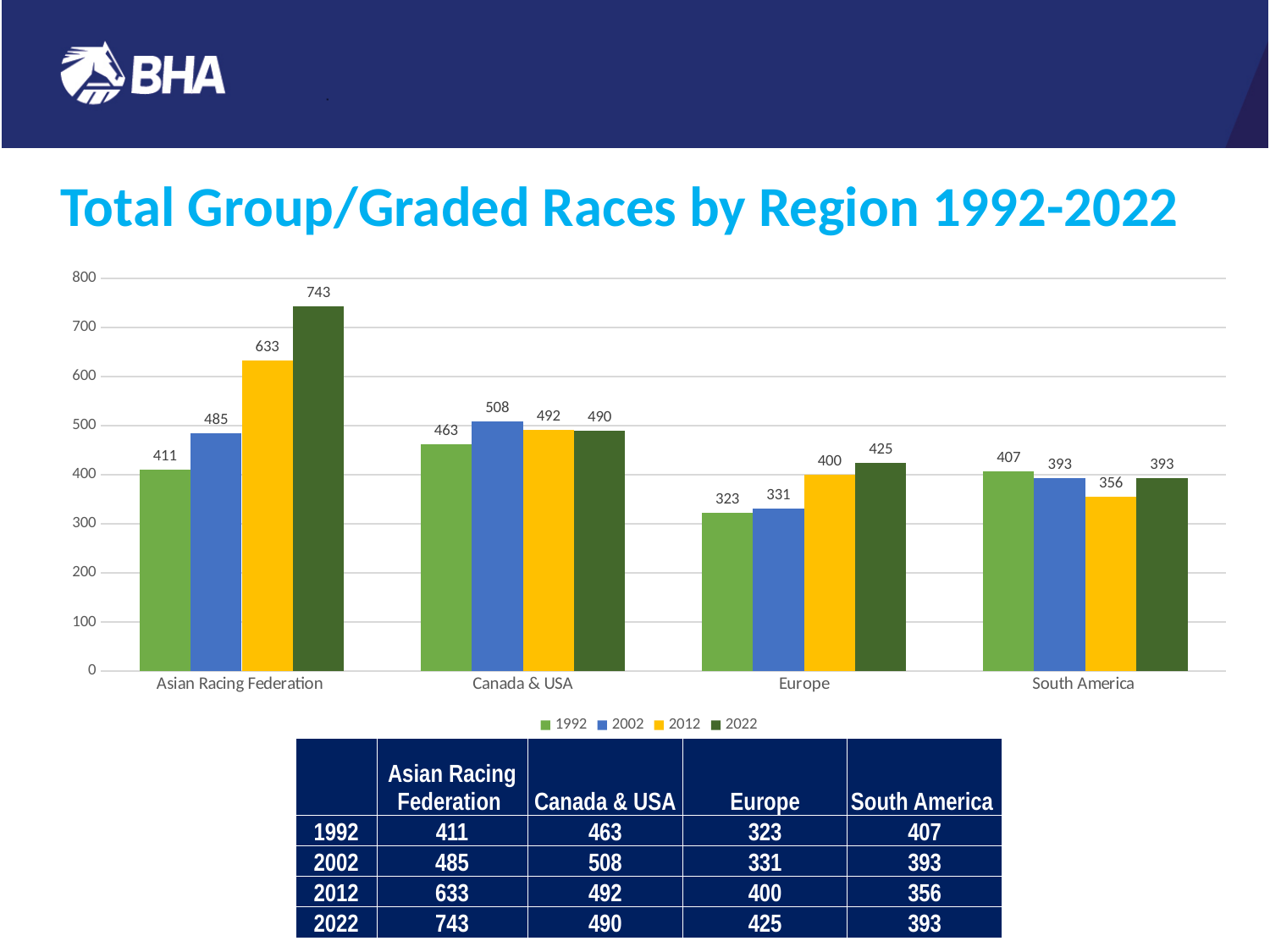
What is the difference between the 2022 and 1992 values for Asian Racing Federation? 332 Which region has the lowest value in 1992? Europe What is the value for South America in 2012? 356 What is the value for Asian Racing Federation in 2022? 743 Do the values for Europe rise or fall from 1992 to 2022? Rise What is the title of the chart? Total Group/Graded Races by Region 1992-2022 How many series does the legend list? 4 How many regions are shown on the x axis? 4 What kind of chart is shown? Bar chart Which region has the highest value in 2022? Asian Racing Federation What is the value for Europe in 1992? 323 Which is larger: Canada & USA in 2002 or Canada & USA in 2012? Canada & USA in 2002